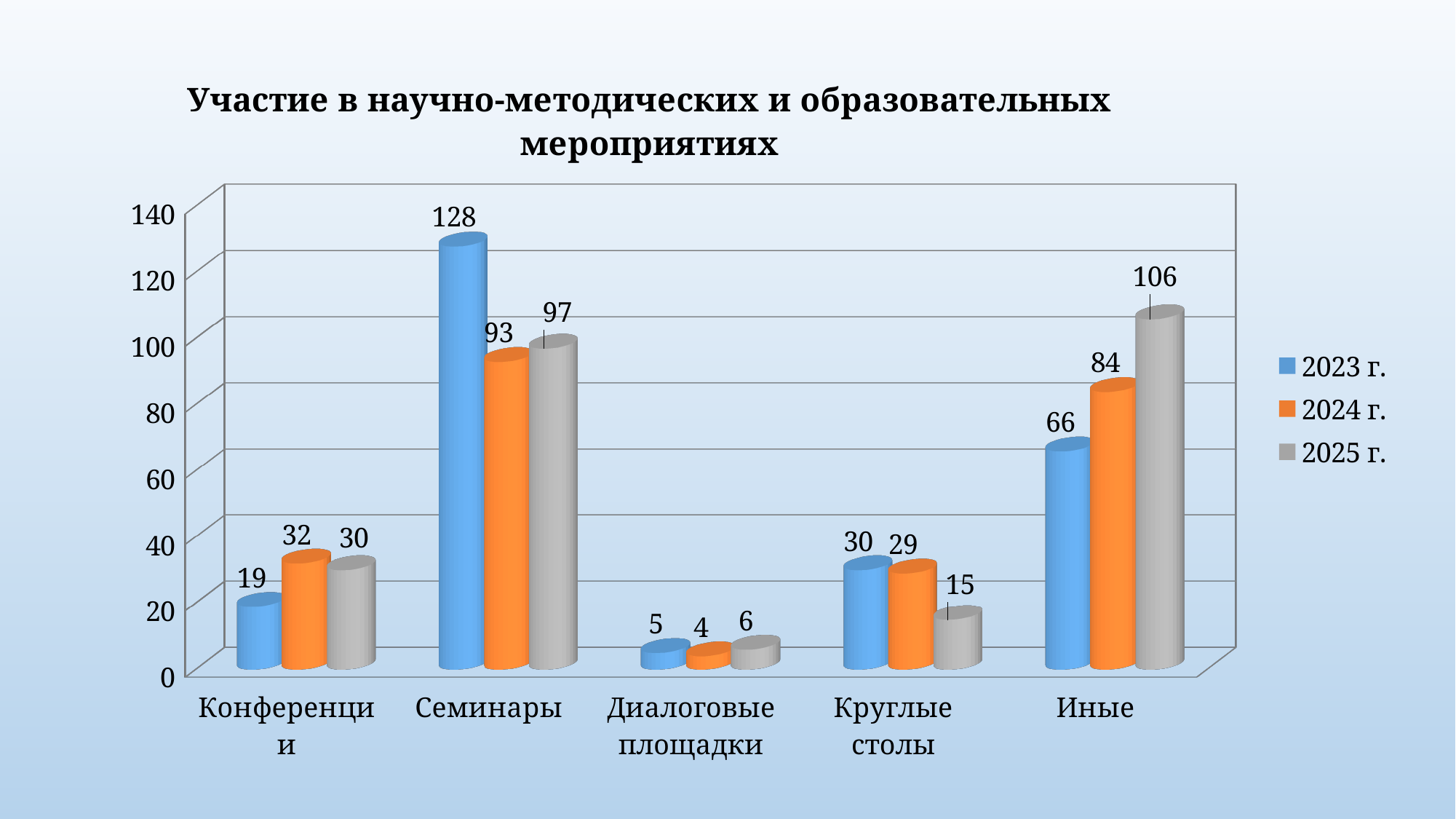
What is the difference between the 2025 г. and 2023 г. values for Иные? 40 Which category has the lowest value in 2025 г.? Диалоговые площадки What kind of chart is shown on the slide? bar chart Do the values for Иные rise or fall from 2023 г. to 2025 г.? rise What is the value for Иные in 2025 г.? 106 Which category has the highest value in 2024 г.? Семинары What is the value for Семинары in 2023 г.? 128 How many categories are shown on the x axis? 5 Is the value for Семинары in 2025 г. greater or less than 100? less What is the value for Круглые столы in 2024 г.? 29 How many series does the legend list? 3 Which is larger for Конференции: the 2024 г. value or the 2025 г. value? 2024 г.